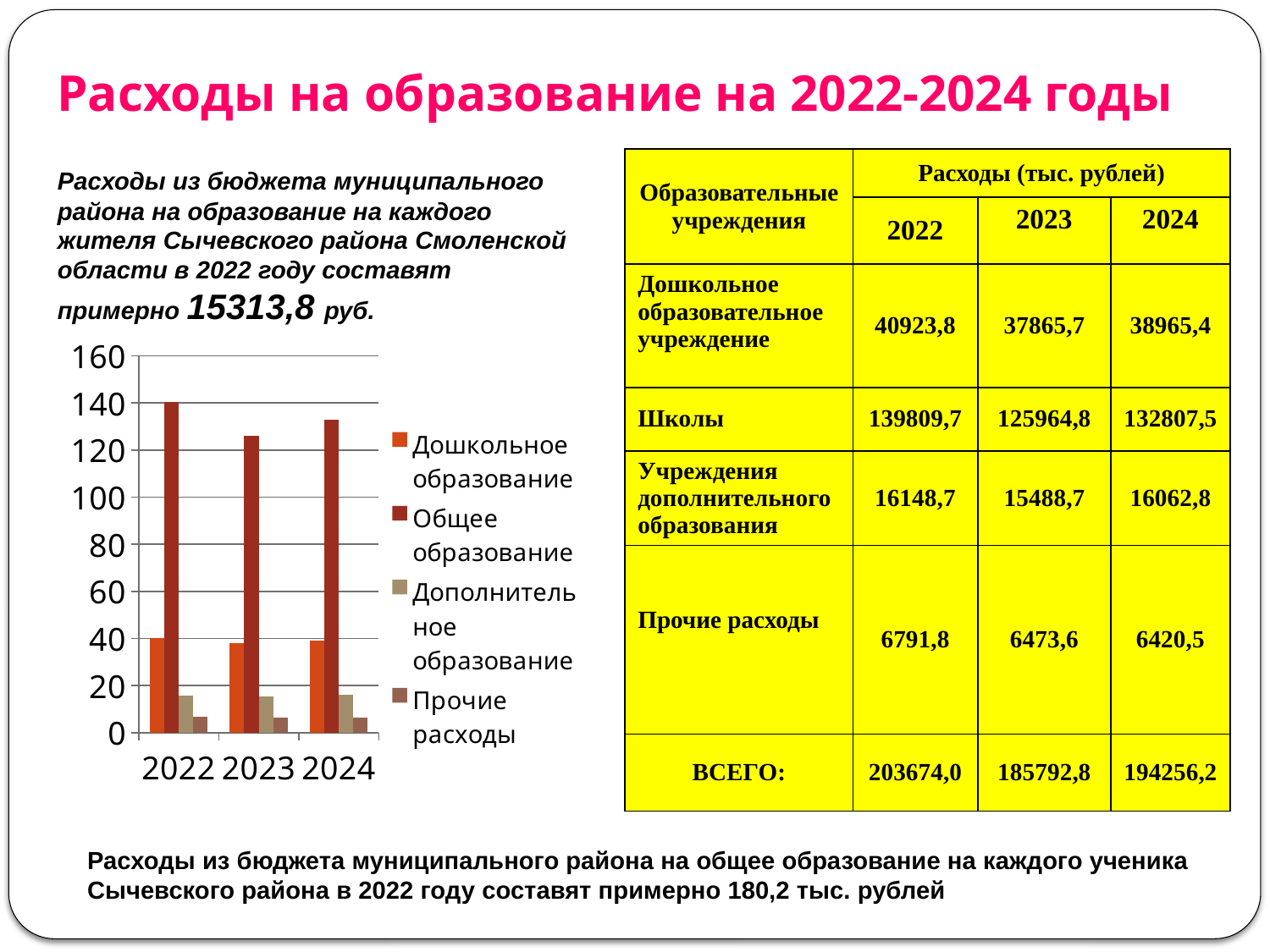
How many years are shown on the x axis of the chart? 3 Is the value for Дошкольное образование in 2022 greater or less than 60? less Is the value for Прочие расходы in 2023 greater or less than 20? less How many series does the chart's legend list? 4 Which is larger in the chart: Общее образование in 2022 or Общее образование in 2023? 2022 Is the value for Общее образование in 2023 greater or less than 140? less What is the highest value shown on the chart's vertical axis? 160 Which series has the tallest bars in the chart? Общее образование Which series has the shortest bars in the chart? Прочие расходы What kind of chart is shown on the slide? bar chart